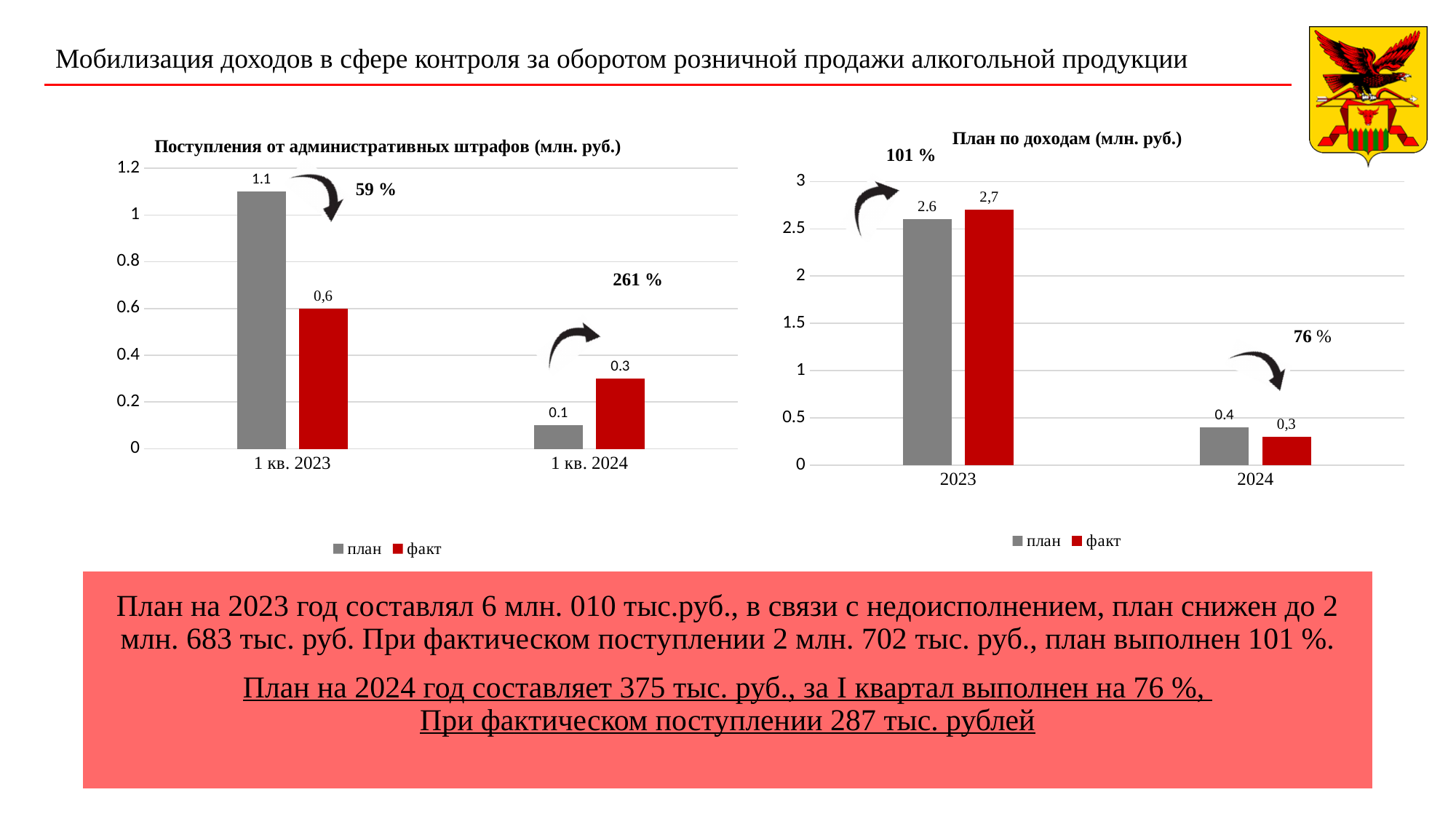
In the chart 'Поступления от административных штрафов (млн. руб.)', what is the план value for 1 кв. 2023? 1.1 What type of chart is 'План по доходам (млн. руб.)'? bar chart In the chart 'Поступления от административных штрафов (млн. руб.)', which is larger for 1 кв. 2024: план or факт? факт In the chart 'Поступления от административных штрафов (млн. руб.)', does the план value rise or fall from 1 кв. 2023 to 1 кв. 2024? fall In the chart 'План по доходам (млн. руб.)', which category has the highest план value? 2023 In the chart 'План по доходам (млн. руб.)', what is the факт value for 2023? 2,7 In the chart 'План по доходам (млн. руб.)', what is the план value for 2024? 0.4 In the chart 'План по доходам (млн. руб.)', is the план value for 2023 greater or less than 2? greater In the chart 'План по доходам (млн. руб.)', how many categories are shown on the x axis? 2 In the chart 'Поступления от административных штрафов (млн. руб.)', how many series does the legend list? 2 In the chart 'Поступления от административных штрафов (млн. руб.)', what is the факт value for 1 кв. 2024? 0.3 In the chart 'Поступления от административных штрафов (млн. руб.)', which is larger for 1 кв. 2023: план or факт? план